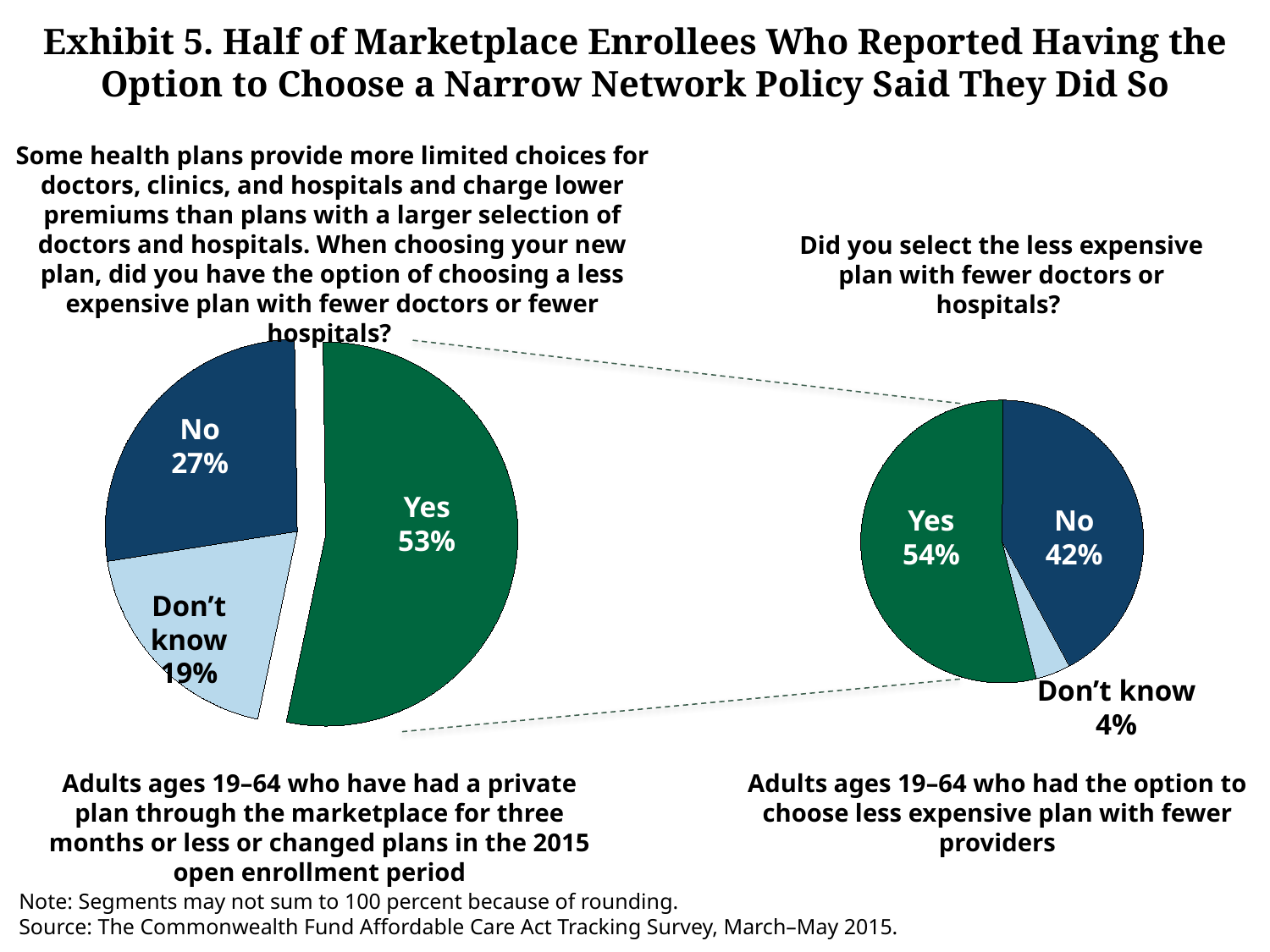
In the right pie chart, which response has the smallest share? Don't know In the left pie chart, which is larger, the No share or the Don't know share? No In the left pie chart, what percentage of respondents answered Don't know? 19% In the left pie chart, which response has the largest share? Yes What type of chart is used on the left side of the slide? Pie chart How many segments does the right pie chart have? 3 In the left pie chart, what percentage of respondents answered No? 27% In the right pie chart, what is the difference in percentage points between Yes and No? 12 In the right pie chart, what percentage said Yes to selecting the less expensive plan with fewer doctors or hospitals? 54% In the left pie chart, what percentage of respondents said Yes to having the option of choosing a less expensive plan with fewer doctors or hospitals? 53% In the right pie chart, what percentage answered No? 42% In the right pie chart, what percentage answered Don't know? 4%